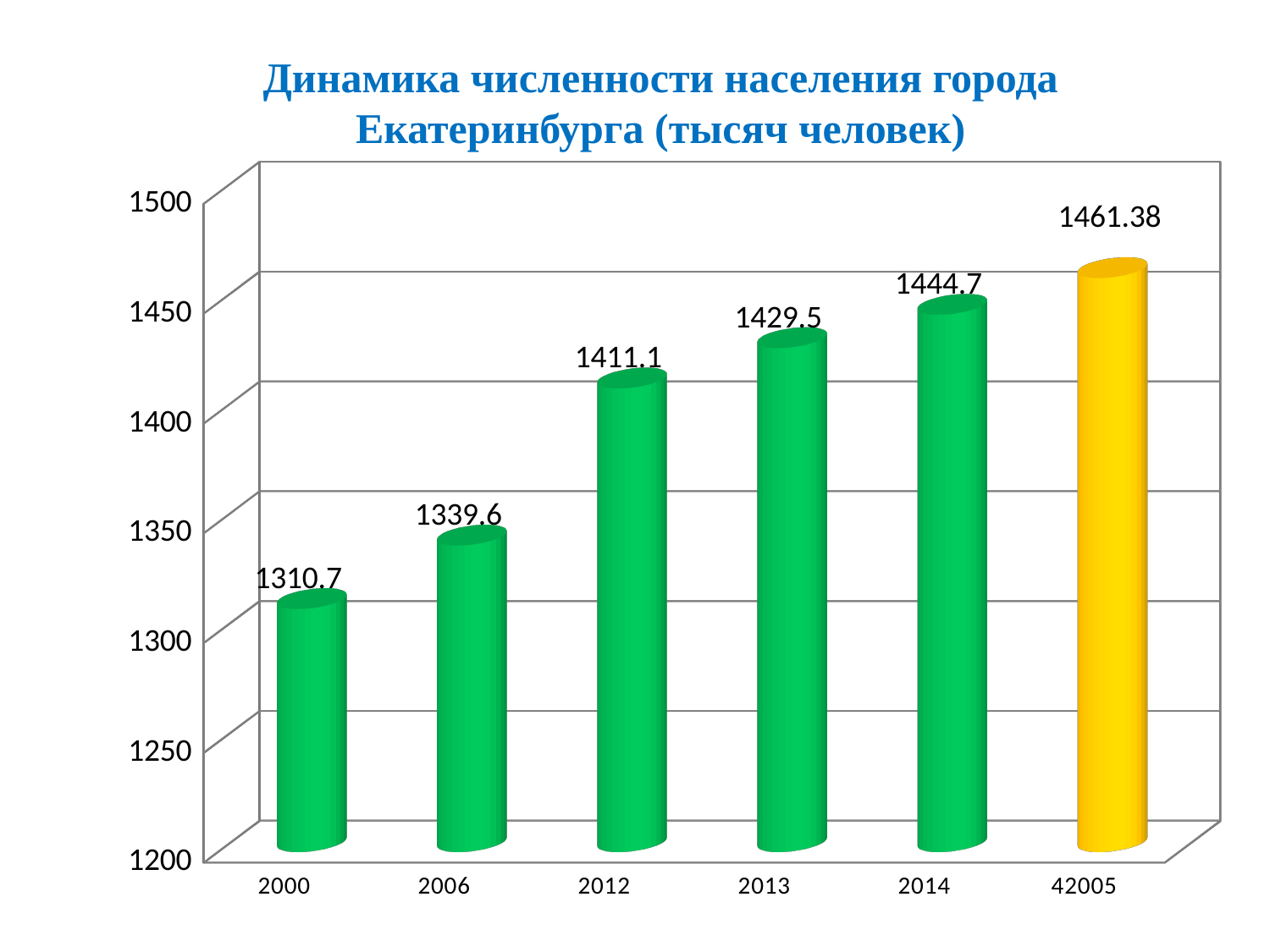
What is the value for the category labelled 42005? 1461.38 Is the value for 2013 greater or less than 1400? greater What is the difference between the values for 2014 and 2013? 15.2 What kind of chart is this? bar chart How many categories are shown on the x axis? 6 Do the values rise or fall from left to right along the x axis? rise What is the value for 2000? 1310.7 What is the difference between the values for 2006 and 2000? 28.9 Which category has the lowest value? 2000 Which is larger, the value for 2012 or the value for 2006? 2012 Which category has the highest value? 42005 What is the value for 2012? 1411.1